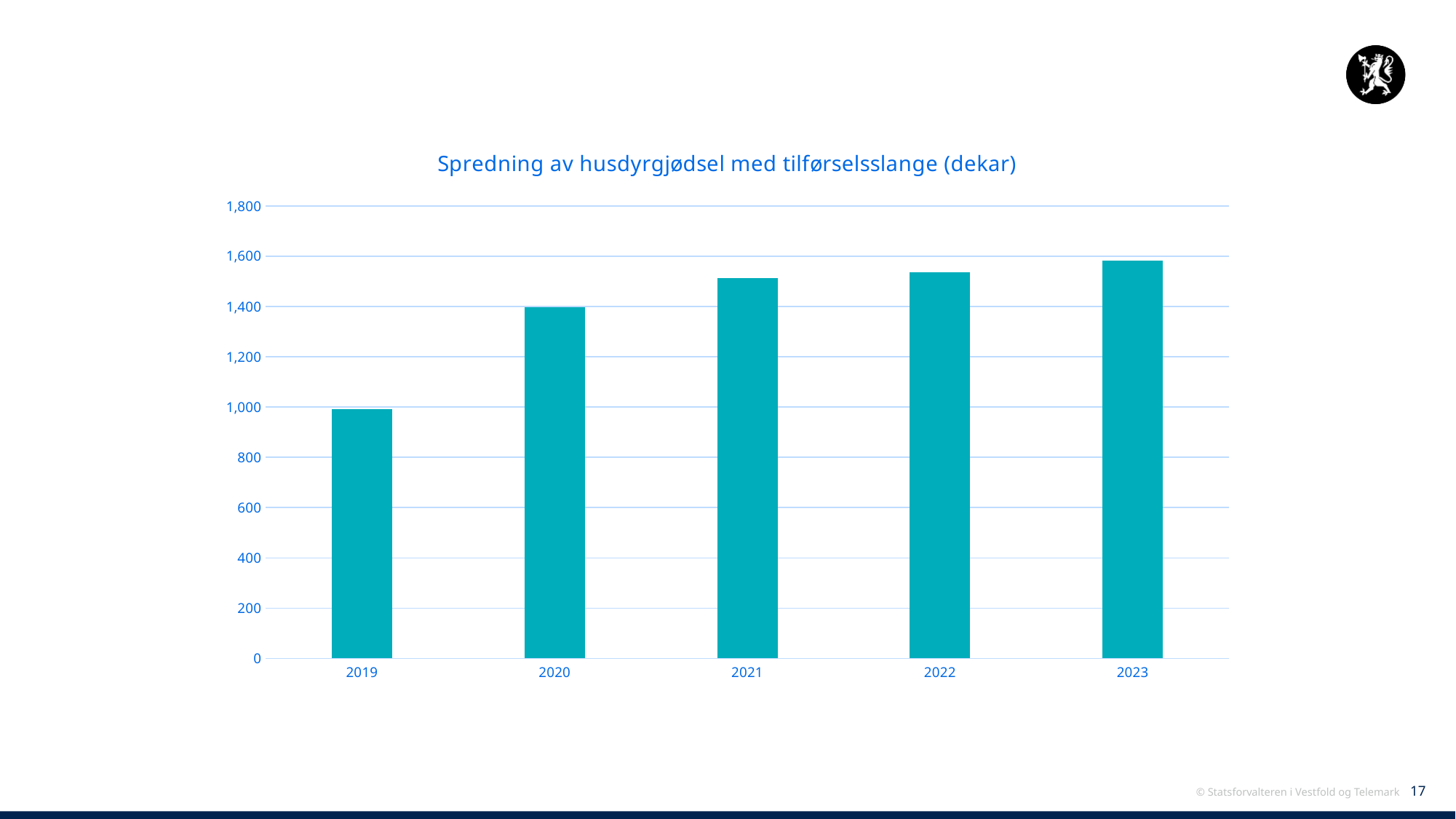
Is the value for 2023 greater or less than 1,400? greater Is the value for 2021 greater or less than 1,600? less Which year has the highest value in the chart? 2023 How many years are shown on the x axis of the chart? 5 Do the values rise or fall from 2019 to 2023? rise Is the value for 2020 greater or less than 1,200? greater Which year has the lowest value in the chart? 2019 Which year has the larger value, 2019 or 2020? 2020 What kind of chart is shown on the slide? bar chart Which year has the larger value, 2020 or 2023? 2023 What is the title of the chart? Spredning av husdyrgjødsel med tilførselsslange (dekar)